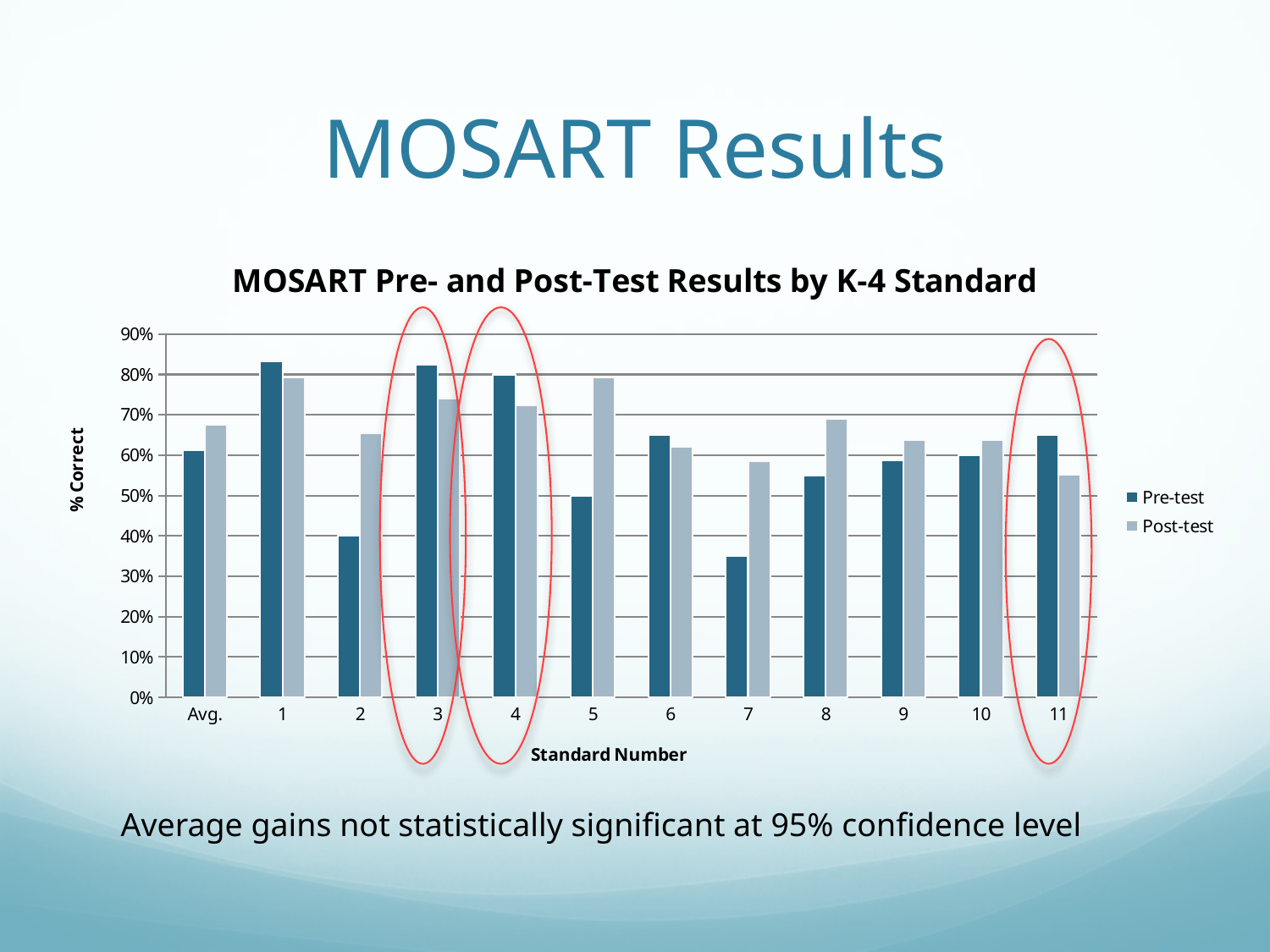
Is the Post-test value for Standard 5 greater or less than 70%? greater For Standard 11, which is larger, the Pre-test or the Post-test value? Pre-test Is the Pre-test value for Standard 1 greater or less than 80%? greater What is the label on the y axis of the chart? % Correct What kind of chart is shown on the slide? Bar chart Is the Pre-test value for Standard 7 greater or less than 40%? less What is the title of the chart? MOSART Pre- and Post-Test Results by K-4 Standard How many categories are shown along the x axis? 12 For Standard 2, which is larger, the Pre-test or the Post-test value? Post-test Which standard has the lowest Pre-test value? 7 How many series does the legend list? 2